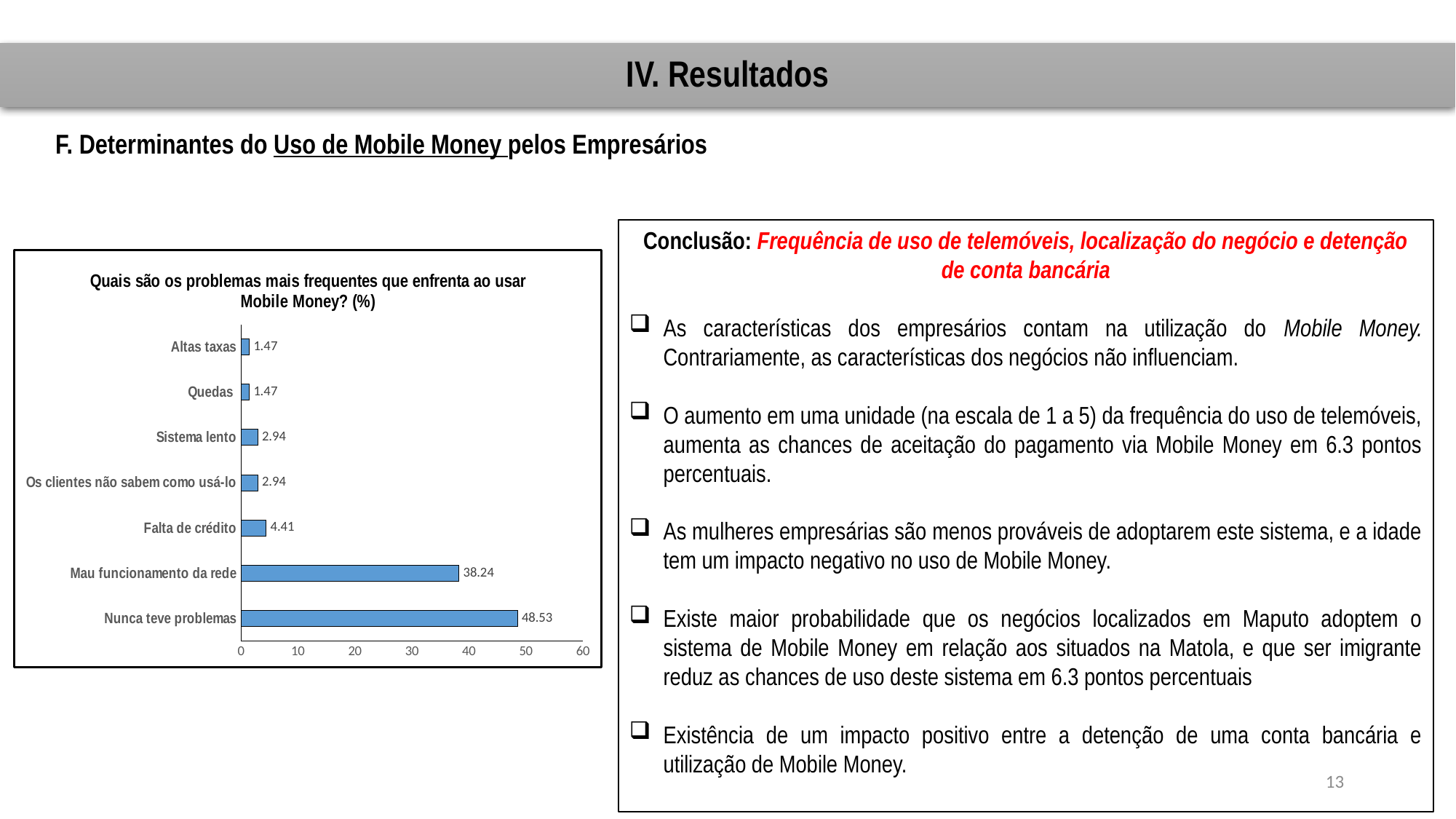
What is the value for "Altas taxas"? 1.47 What kind of chart is shown on the slide? Bar chart What is the difference between the values for "Nunca teve problemas" and "Mau funcionamento da rede"? 10.29 What is the value for "Falta de crédito"? 4.41 What is the value for "Mau funcionamento da rede"? 38.24 Which is larger, the value for "Falta de crédito" or the value for "Sistema lento"? Falta de crédito Which category has the highest value? Nunca teve problemas Is the value for "Mau funcionamento da rede" greater or less than 30? greater What is the title of the chart? Quais são os problemas mais frequentes que enfrenta ao usar Mobile Money? (%) What is the value for "Nunca teve problemas"? 48.53 What is the value for "Sistema lento"? 2.94 How many categories are shown in the chart? 7